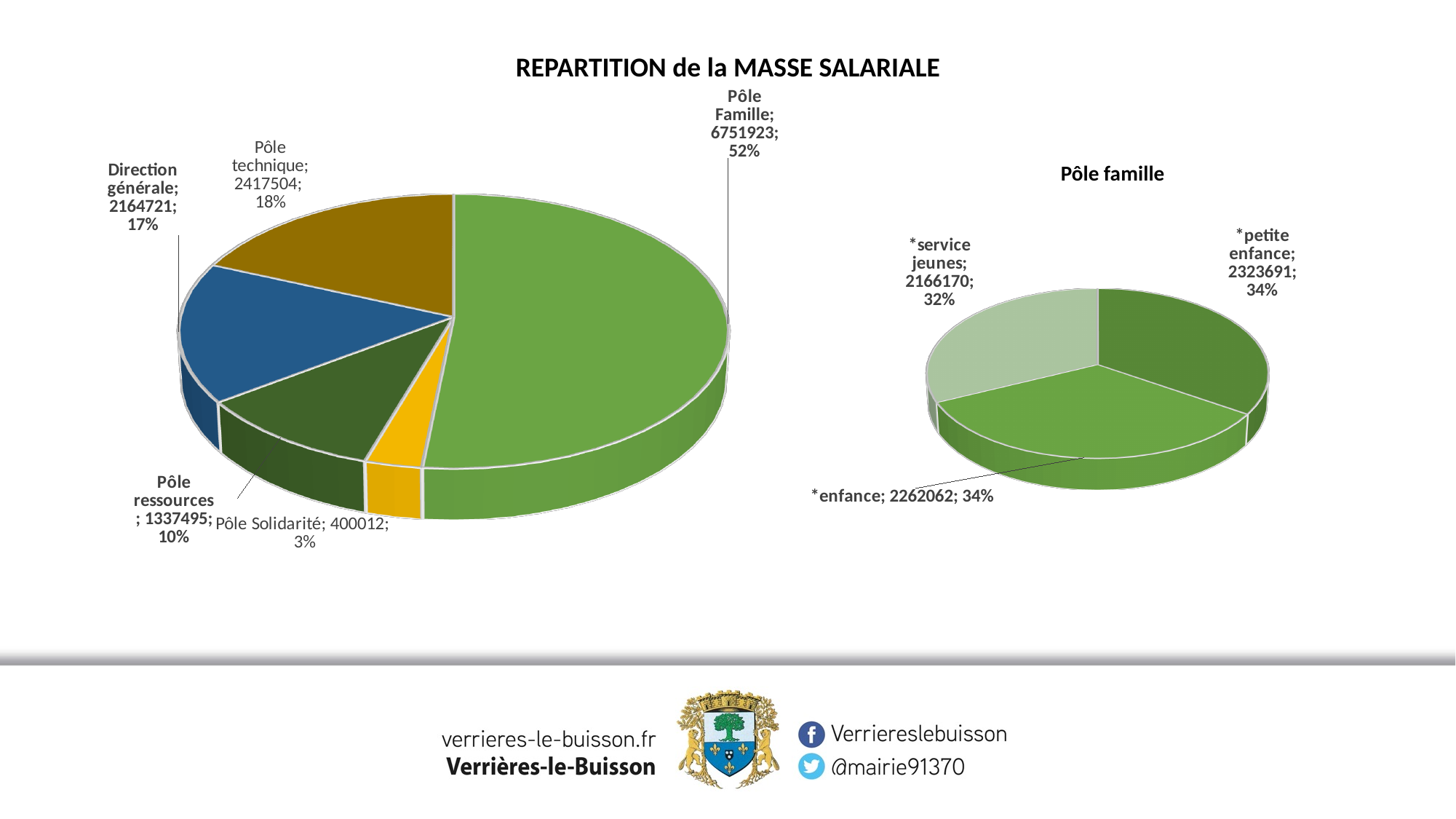
In the 'Pôle famille' chart, what percentage share does petite enfance have? 34% In the 'REPARTITION de la MASSE SALARIALE' chart, what percentage share does Pôle technique have? 18% In the 'REPARTITION de la MASSE SALARIALE' chart, which category has the largest slice? Pôle Famille In the 'Pôle famille' chart, what value is shown for service jeunes? 2166170 How many categories are shown in the 'REPARTITION de la MASSE SALARIALE' chart? 5 In the 'REPARTITION de la MASSE SALARIALE' chart, which is larger: Pôle ressources or Pôle Solidarité? Pôle ressources In the 'REPARTITION de la MASSE SALARIALE' chart, what is the difference between the values for Pôle technique and Direction générale? 252783 In the 'Pôle famille' chart, what is the difference between the values for petite enfance and enfance? 61629 In the 'REPARTITION de la MASSE SALARIALE' chart, which category has the smallest slice? Pôle Solidarité What kind of chart is the 'Pôle famille' chart on the right? Pie chart How many slices does the 'Pôle famille' chart have? 3 In the 'REPARTITION de la MASSE SALARIALE' chart, what value is shown for Pôle Famille? 6751923